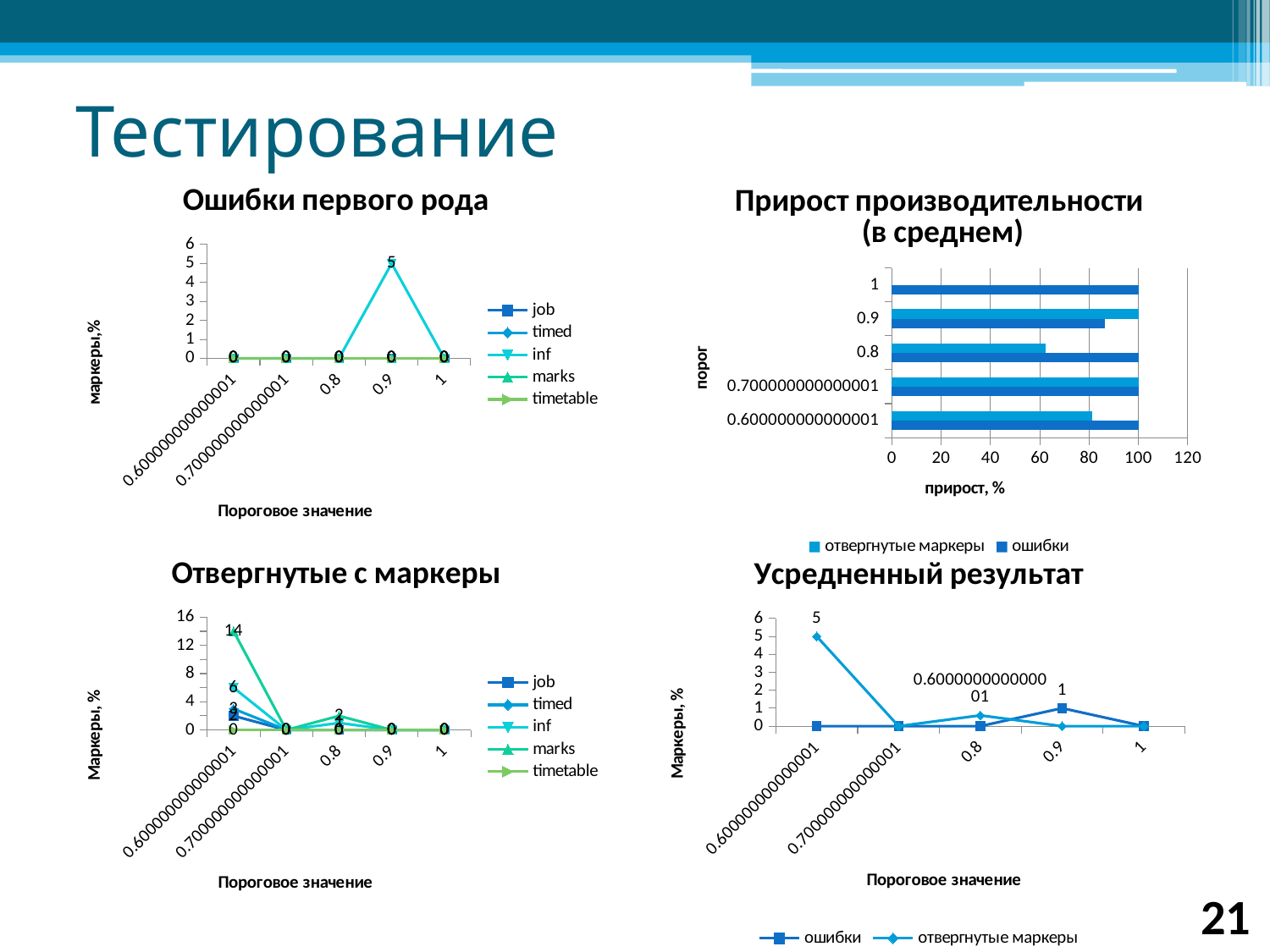
In "Прирост производительности (в среднем)", which series has the larger value for порог 0.8, отвергнутые маркеры or ошибки? ошибки In "Прирост производительности (в среднем)", is the value of отвергнутые маркеры for порог 0.8 greater or less than 80? less In "Ошибки первого рода", what is the value of the inf series at threshold 0.9? 5 In "Усредненный результат", what is the value of отвергнутые маркеры at threshold 0.600000000000001? 5 How many series does the legend of "Усредненный результат" list? 2 In "Отвергнутые с маркеры", what is the value of the marks series at threshold 0.600000000000001? 14 In "Усредненный результат", what is the value of ошибки at threshold 0.9? 1 How many series does the legend of "Ошибки первого рода" list? 5 What type of chart is "Прирост производительности (в среднем)"? bar chart What type of chart is "Ошибки первого рода"? line chart How many categories are shown on the x axis of "Отвергнутые с маркеры"? 5 In "Отвергнутые с маркеры", what is the value of the timed series at threshold 0.600000000000001? 3